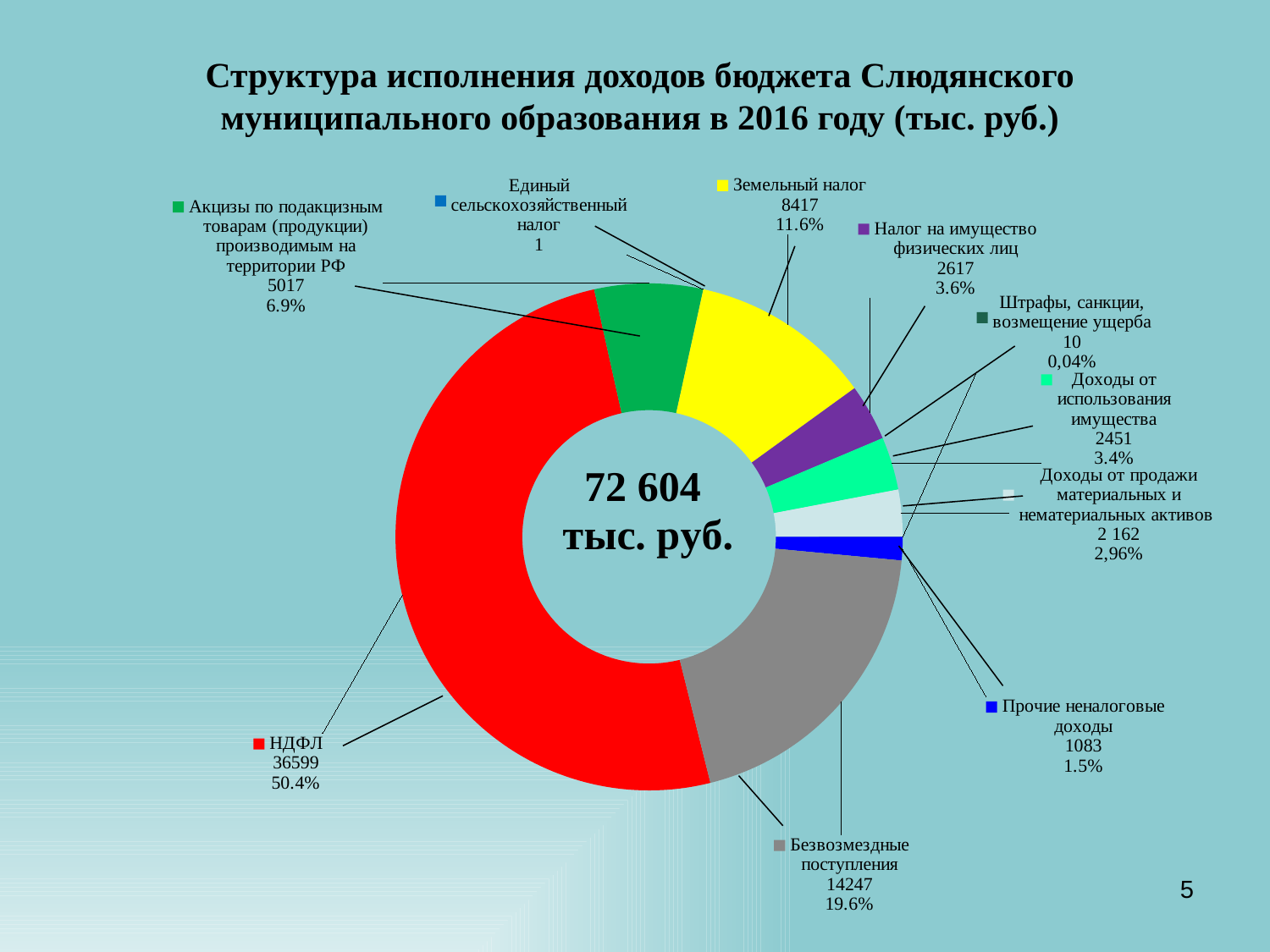
What share of the total does Безвозмездные поступления represent? 19.6% What share of the total does НДФЛ represent? 50.4% What is the value for Налог на имущество физических лиц? 2617 What kind of chart is shown on the slide? Doughnut (pie) chart What is the value for Земельный налог? 8417 What is the value for НДФЛ? 36599 What is the difference between the values for Земельный налог and Акцизы по подакцизным товарам? 3400 What is the value for Безвозмездные поступления? 14247 Which category has the smallest value? Единый сельскохозяйственный налог How many categories are shown in the chart? 10 Which is larger: Доходы от использования имущества or Прочие неналоговые доходы? Доходы от использования имущества Which category has the largest value? НДФЛ